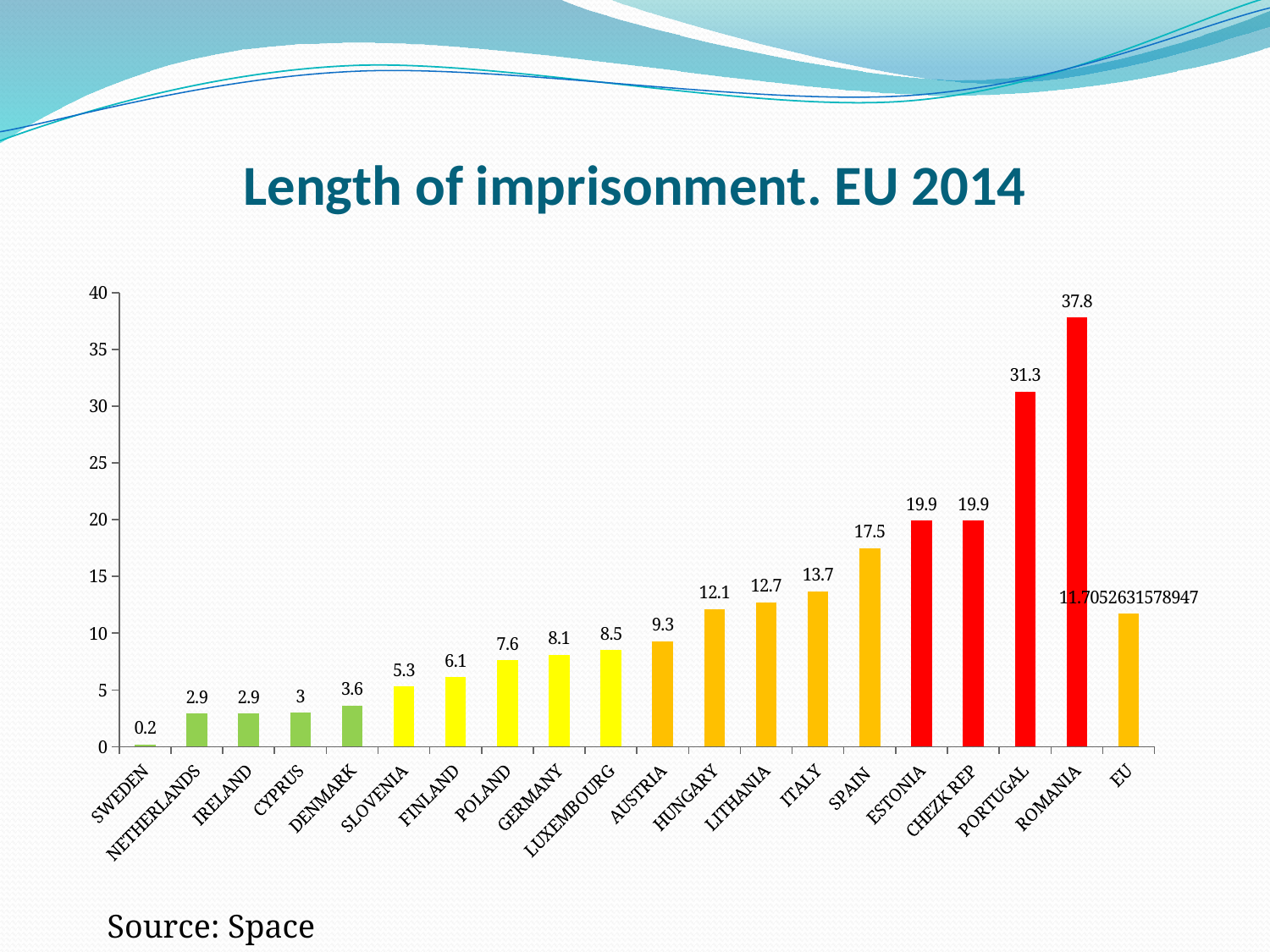
What is the title of the chart? Length of imprisonment. EU 2014 What is the value for Sweden? 0.2 What is the value for Portugal? 31.3 How many bars are shown in the chart? 20 Is the value for the EU greater or less than 10? greater What is the value for Romania? 37.8 Which country has the lowest value? Sweden Which country has the highest value? Romania What is the value for Spain? 17.5 Which is larger, the value for Italy or the value for Hungary? Italy What is the difference between the values for Romania and Portugal? 6.5 What kind of chart is shown on the slide? Bar chart